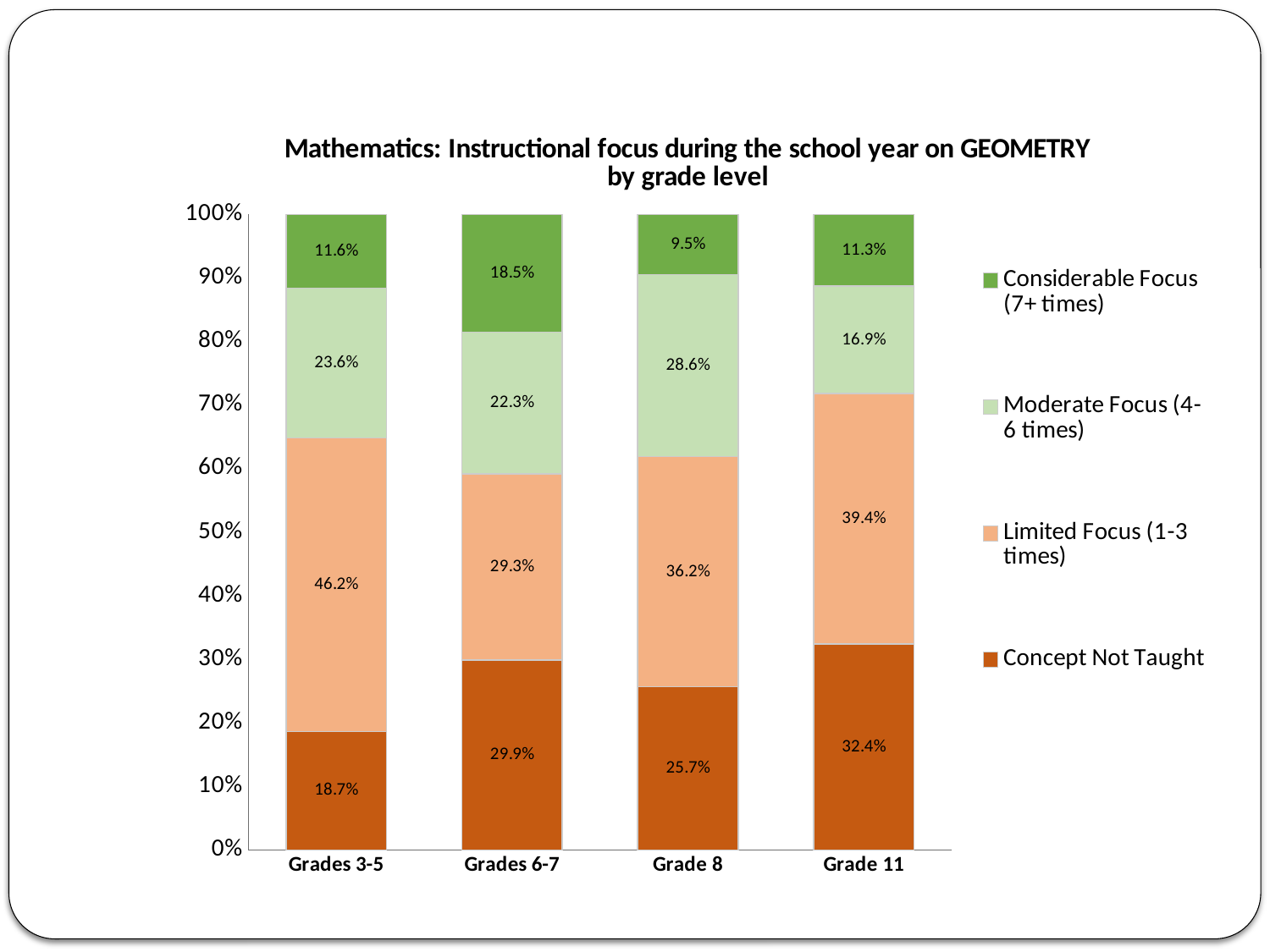
What percentage of Grades 3-5 falls under Limited Focus (1-3 times)? 46.2% What is the Moderate Focus (4-6 times) value for Grade 8? 28.6% Which legend entry is shown in the darkest green colour? Considerable Focus (7+ times) Which is larger: the Moderate Focus (4-6 times) value for Grades 3-5 or for Grade 11? Grades 3-5 What is the Considerable Focus (7+ times) value for Grades 6-7? 18.5% How many series does the legend list? 4 What is the Concept Not Taught value for Grade 11? 32.4% Which grade level has the lowest Considerable Focus (7+ times) percentage? Grade 8 How many grade-level categories are shown on the x axis? 4 What is the difference between the Limited Focus (1-3 times) values for Grades 3-5 and Grades 6-7? 16.9% Which grade level has the highest Concept Not Taught percentage? Grade 11 What kind of chart is shown on the slide? Stacked bar chart